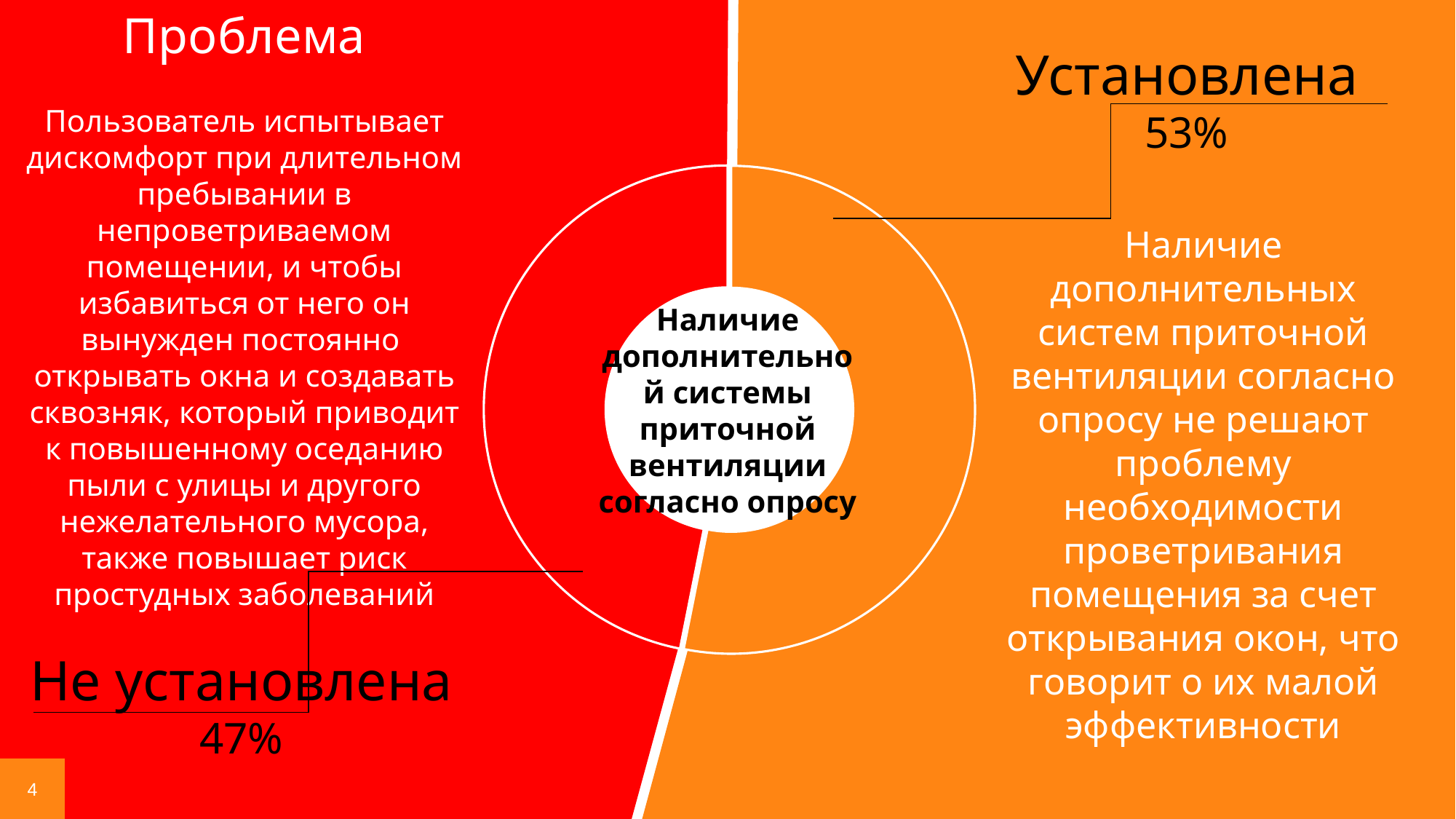
What is the difference in percentage points between Установлена and Не установлена? 6 Which slice of the chart is the smallest? Не установлена How many slices does the chart have? 2 Which slice of the chart is the largest? Установлена Is the share for Не установлена greater or less than 50%? less What is the total of the two slices shown on the chart? 100% What is the title of the chart in the centre of the slide? Наличие дополнительной системы приточной вентиляции согласно опросу Which category has the larger share: Установлена or Не установлена? Установлена What share of respondents have the ventilation system installed (Установлена)? 53% What kind of chart is shown on the slide? doughnut chart What share of respondents do not have the ventilation system installed (Не установлена)? 47% What colour is the Установлена slice of the chart? orange